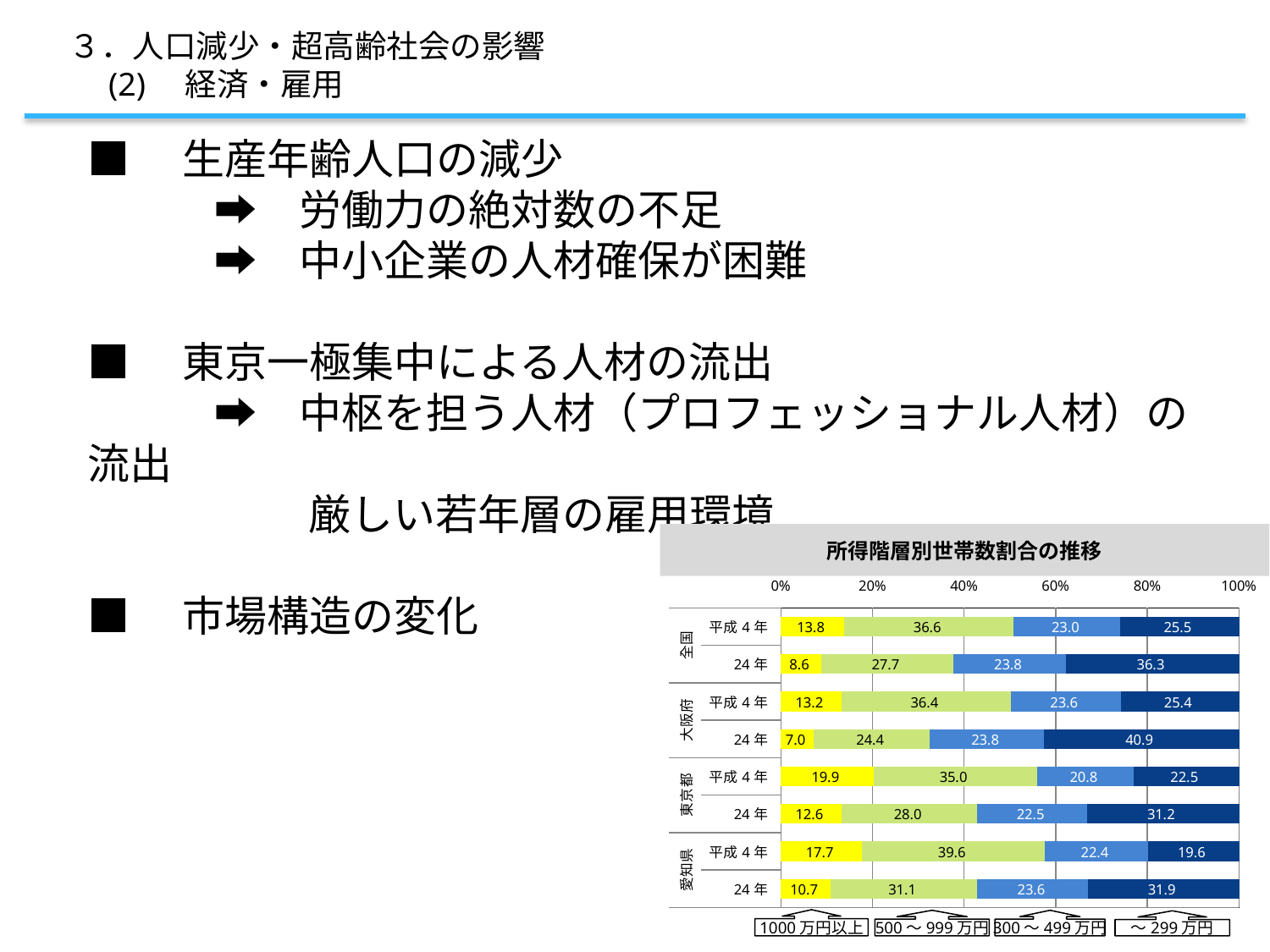
Which is larger: the 500～999万円 value for 東京都 24年 or for 愛知県 24年? 愛知県 24年 What is the value of the 1000万円以上 segment for 全国 平成4年? 13.8 From 平成4年 to 24年, does the 1000万円以上 share for 東京都 rise or fall? fall How many series does the legend of the chart list? 4 What is the value of the 500～999万円 segment for 愛知県 平成4年? 39.6 What type of chart is shown under the title 所得階層別世帯数割合の推移? stacked bar chart What is the difference between the ～299万円 values for 全国 24年 and 全国 平成4年? 10.8 What colour represents the ～299万円 series in the chart? dark blue How many bars are plotted in the chart? 8 Which bar has the lowest value for the 1000万円以上 segment? 大阪府 24年 Which bar has the highest value for the 1000万円以上 segment? 東京都 平成4年 What is the value of the ～299万円 segment for 大阪府 24年? 40.9